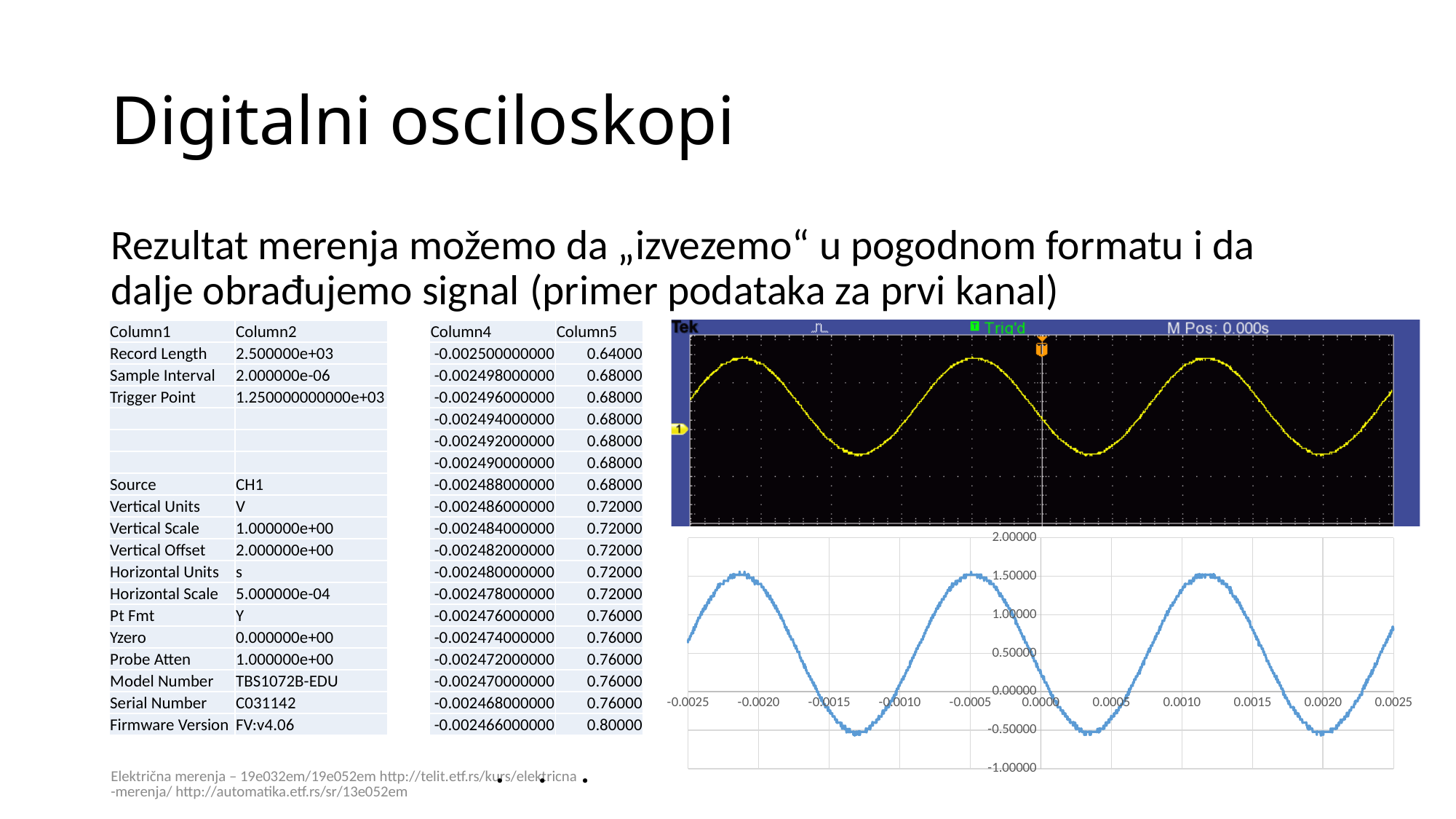
On the bottom-right chart, is the value at x = 0.0020 greater or less than 0.00000? less What is the highest value labelled on the y axis of the bottom-right chart? 2.00000 On the bottom-right chart, is the value at x = -0.0020 greater or less than 1.00000? greater What colour is the line plotted on the bottom-right chart? blue On the bottom-right chart, does the plotted value rise or fall between x = -0.0010 and x = 0.0000? rise How many tick labels are shown on the x axis of the bottom-right chart? 11 On the bottom-right chart, is the peak of the wave greater or less than 2.00000? less On the bottom-right chart, does the plotted value rise or fall between x = -0.0020 and x = -0.0010? fall What kind of chart is the blue chart at the bottom right of the slide? line chart